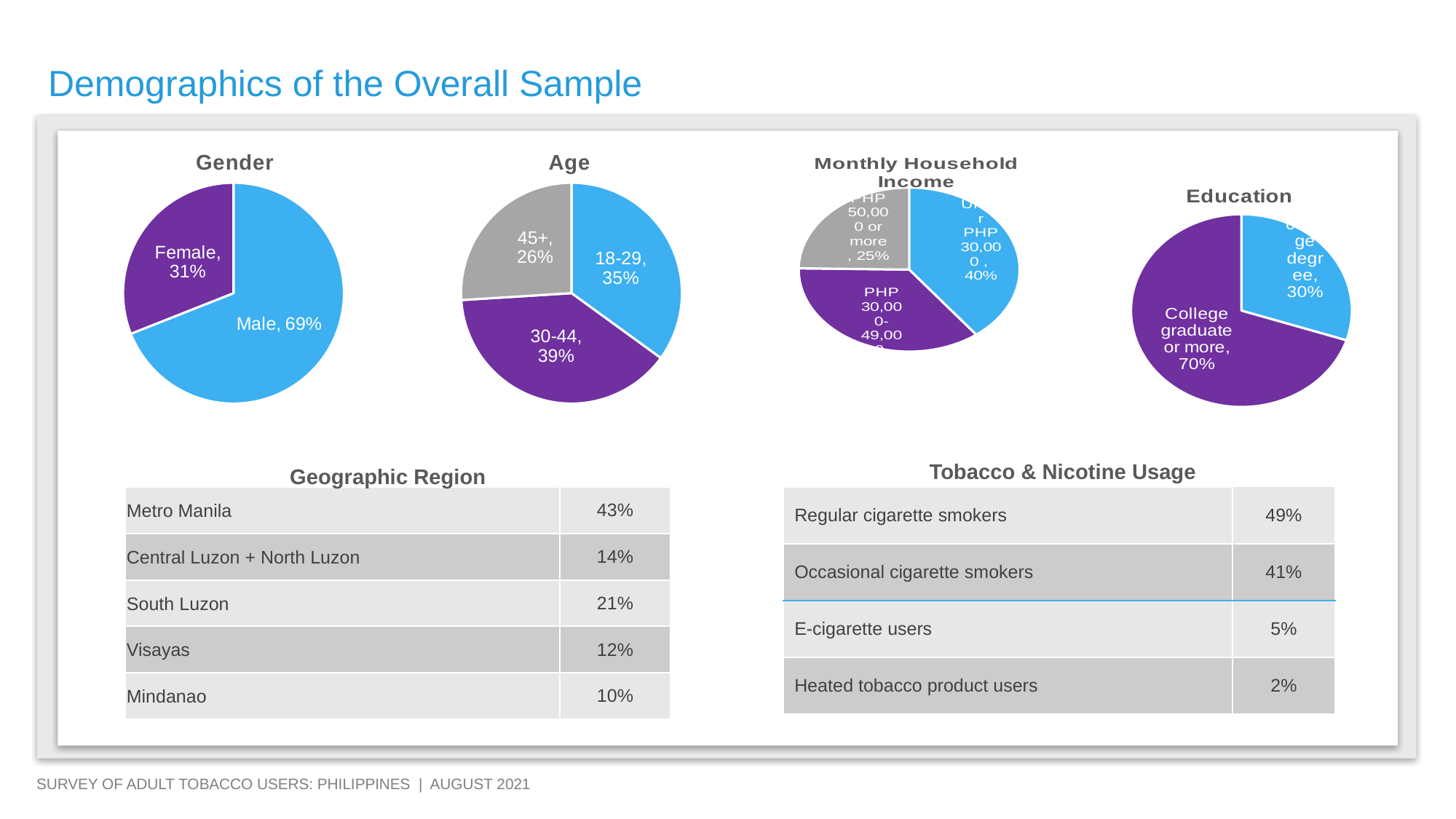
In the Education pie chart, what share of the sample is College graduate or more? 70% In the Gender pie chart, what percentage of the sample is Female? 31% How many age groups are shown in the Age pie chart? 3 What type of chart is used for the Gender breakdown? Pie chart In the Gender pie chart, by how many percentage points does Male exceed Female? 38% In the Age pie chart, which is larger: the 18-29 group or the 45+ group? 18-29 In the Age pie chart, what is the difference between the 18-29 share and the 45+ share? 9% In the Monthly Household Income pie chart, what share of the sample has income of PHP 50,000 or more? 25% In the Age pie chart, which age group has the largest share? 30-44 In the Gender pie chart, what percentage of the sample is Male? 69% In the Age pie chart, which age group has the smallest share? 45+ In the Age pie chart, what share of the sample is aged 30-44? 39%